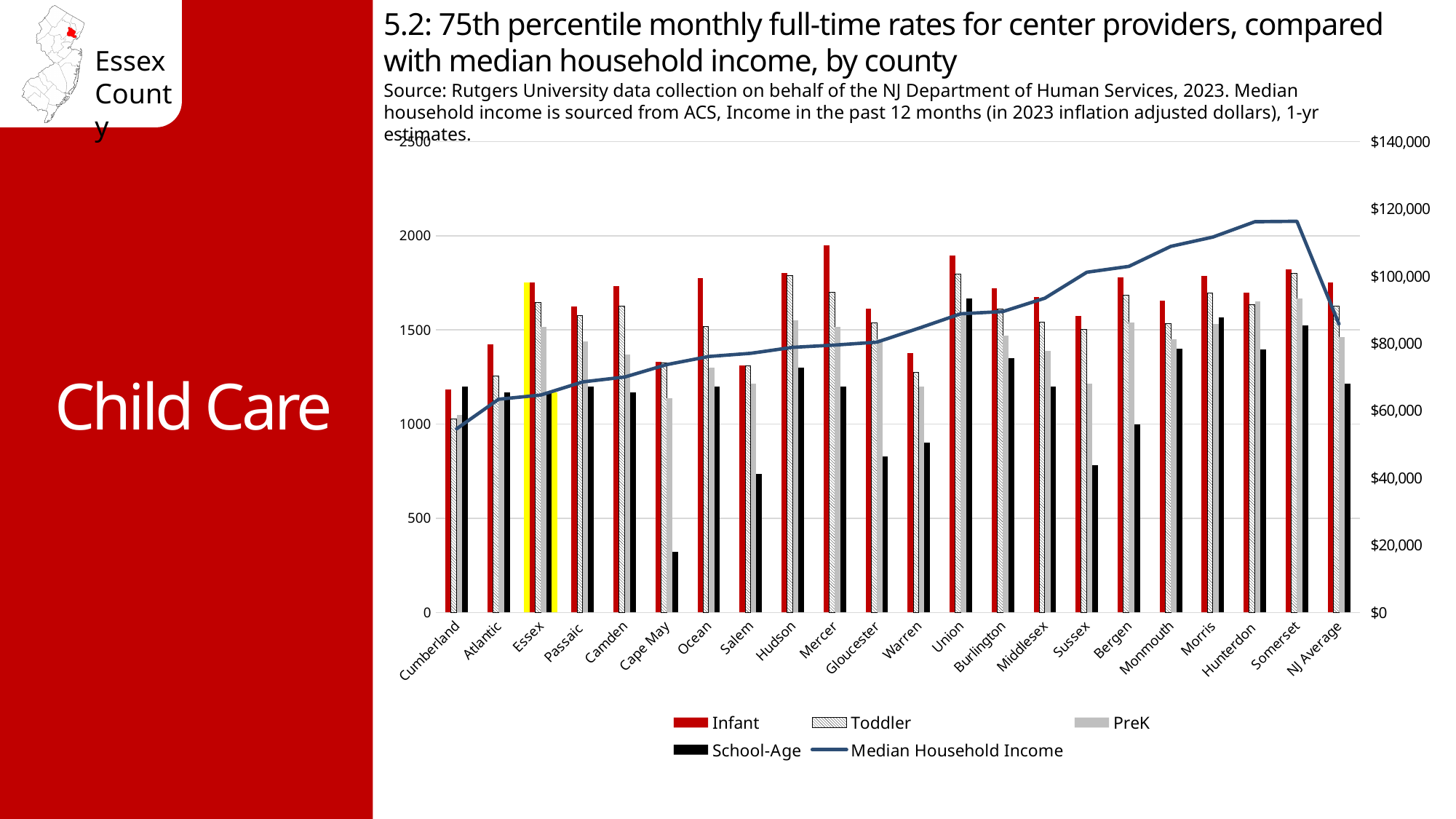
Which is larger, the Infant rate for Mercer or the Infant rate for Cumberland? Mercer Is the School-Age value for Cape May greater or less than 500? less Which county has the lowest School-Age rate? Cape May Which county has the highest Infant rate? Mercer Does the Median Household Income line generally rise or fall from Cumberland to Somerset? rise How many counties (including NJ Average) are shown on the x axis? 22 What kind of chart is this? Bar chart with a line Is the Infant value for Mercer greater or less than 1500? greater How many series does the legend list? 5 Which county's bars are highlighted in yellow? Essex Which county has the lowest Infant rate? Cumberland Is the School-Age value for Salem greater or less than 1000? less